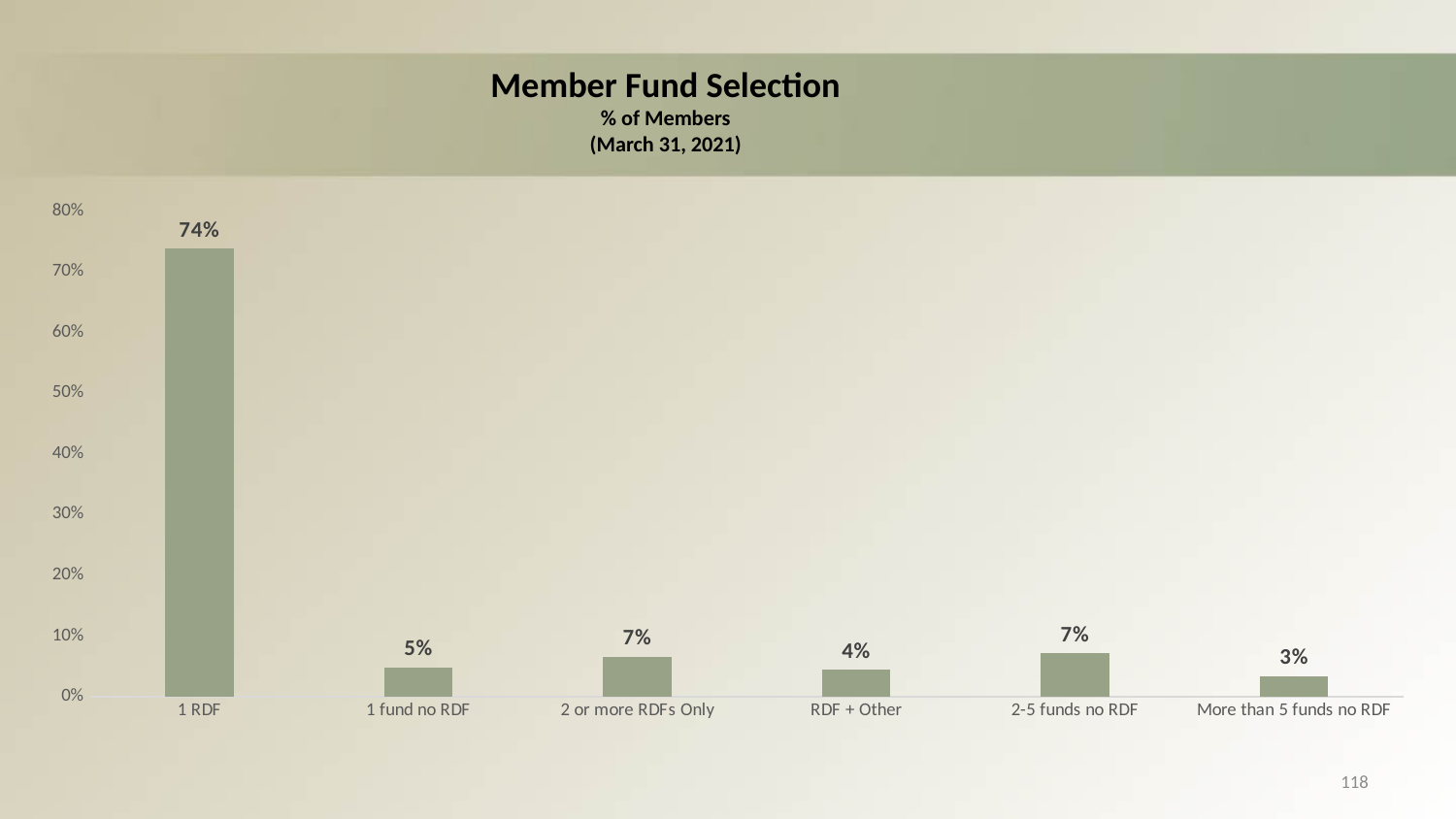
How many categories are shown on the x axis? 6 What is the value for 'More than 5 funds no RDF'? 3% Which is larger, the value for '1 fund no RDF' or the value for '2-5 funds no RDF'? 2-5 funds no RDF What percentage of members selected 1 RDF? 74% What date is shown in the chart subtitle? March 31, 2021 What is the title of the chart? Member Fund Selection What kind of chart is shown on the slide? bar chart Is the value for '1 RDF' greater or less than 70%? greater What is the value for 'RDF + Other'? 4% What is the difference between the values for '1 RDF' and '2 or more RDFs Only'? 67% Which category has the highest percentage of members? 1 RDF Which category has the lowest percentage of members? More than 5 funds no RDF